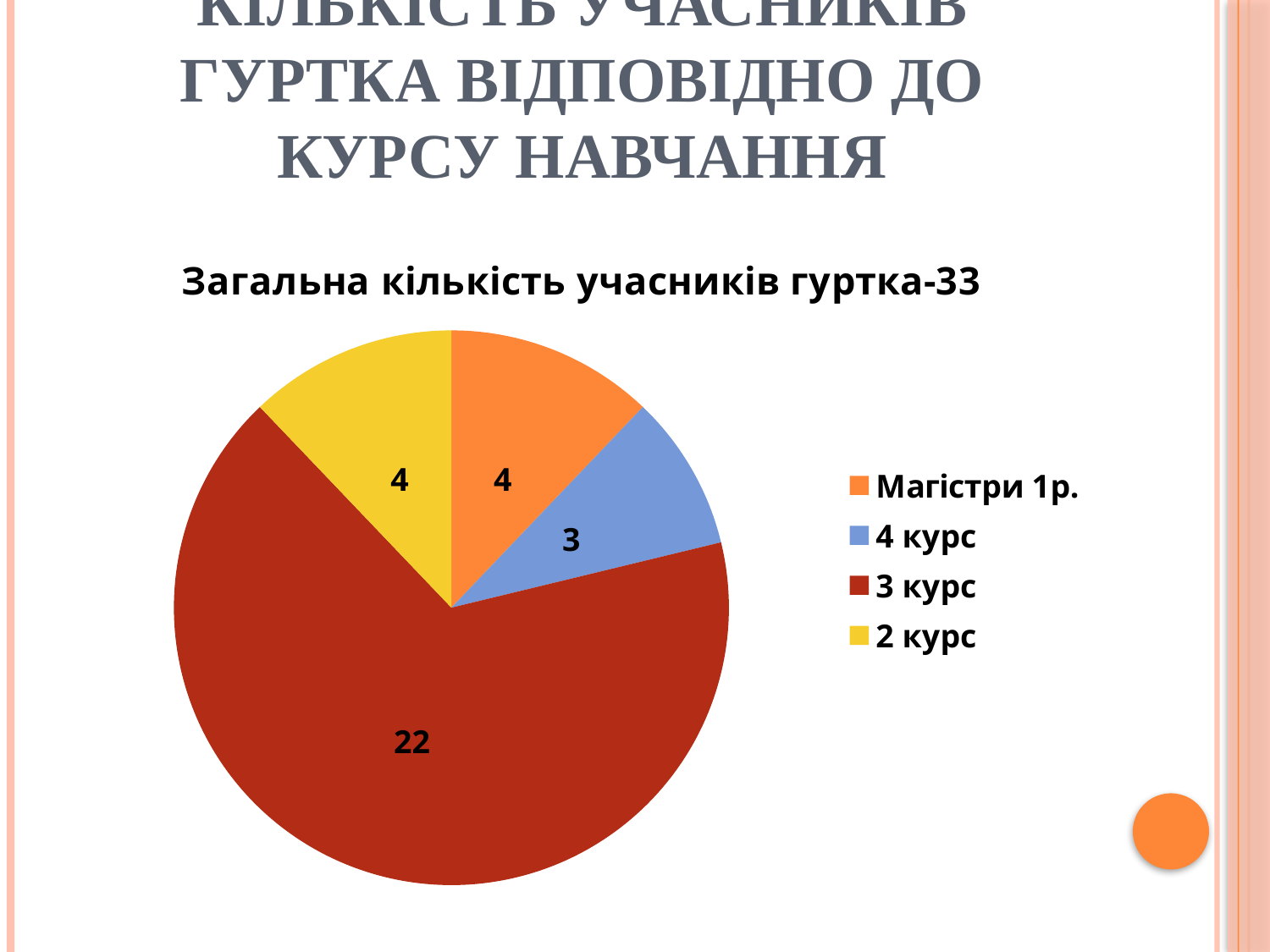
Which is larger, the value for "Магістри 1р." or the value for "4 курс"? Магістри 1р. What value is shown for the "4 курс" slice? 3 What is the total number of participants shown in the chart title? 33 What is the difference between the values for "3 курс" and "4 курс"? 19 What value is shown for the "Магістри 1р." slice? 4 What colour is the "3 курс" slice in the pie chart? Dark red What value is shown for the "2 курс" slice? 4 Which category has the smallest slice of the pie chart? 4 курс How many categories does the pie chart have? 4 Which category has the largest slice of the pie chart? 3 курс How many participants are in the "3 курс" slice of the pie chart? 22 What type of chart is shown on the slide? Pie chart